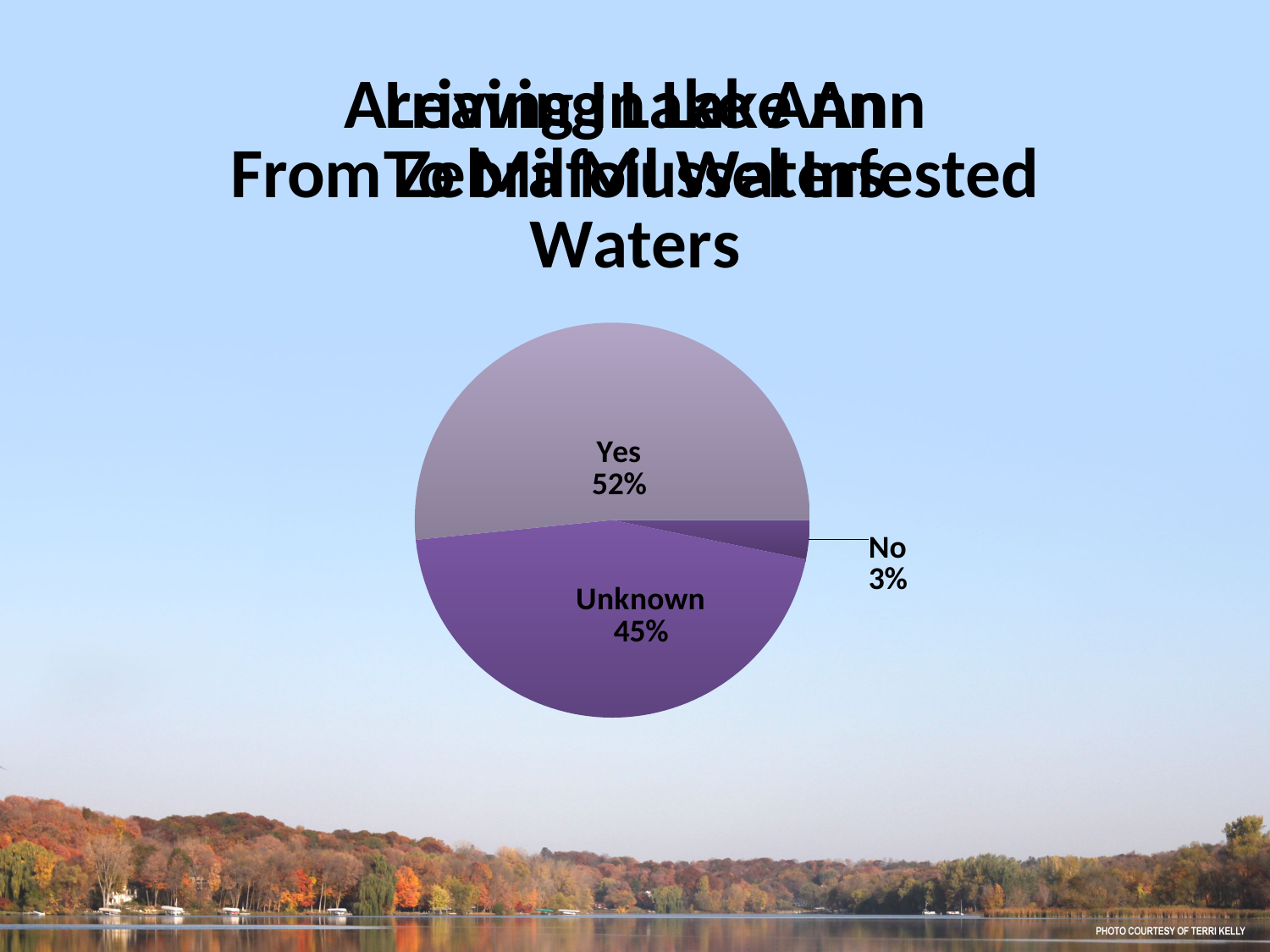
Which is larger, the "Unknown" slice or the "No" slice? Unknown Which slice of the pie chart is the largest? Yes What share of the pie is labelled "Yes"? 52% What is the difference in percentage points between the "Unknown" and "No" slices? 42 How many slices does the pie chart have? 3 What kind of chart is shown on the slide? pie chart What is the difference in percentage points between the "Yes" and "Unknown" slices? 7 Is the "Yes" slice greater or less than 50% of the pie? greater Which slice of the pie chart is the smallest? No What share of the pie is labelled "Unknown"? 45% Which slice of the pie chart is labelled with a leader line pointing outside the pie? No What share of the pie is labelled "No"? 3%